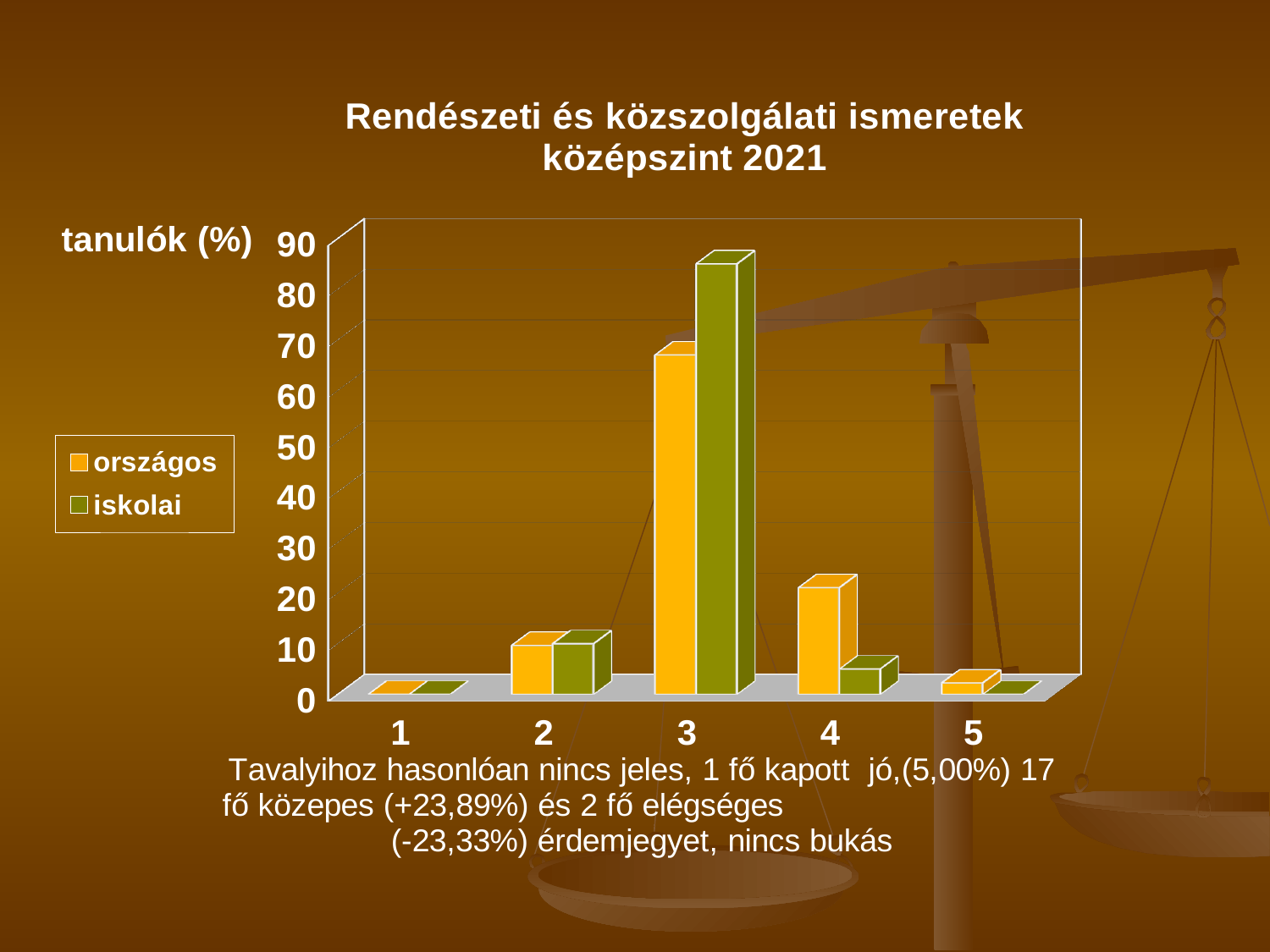
For category 4, which series has the larger value, országos or iskolai? országos Which category has the highest value for the iskolai series? 3 What kind of chart is shown on the slide? bar chart Is the országos value for category 3 greater or less than 60? greater How many categories are shown on the x axis? 5 Which series is shown in green? iskolai Which category has the highest value for the országos series? 3 How many series does the legend list? 2 Is the iskolai value for category 3 greater or less than 80? greater For category 3, which series has the larger value, országos or iskolai? iskolai Is the iskolai value for category 4 greater or less than 10? less What is the label of the vertical axis? tanulók (%)